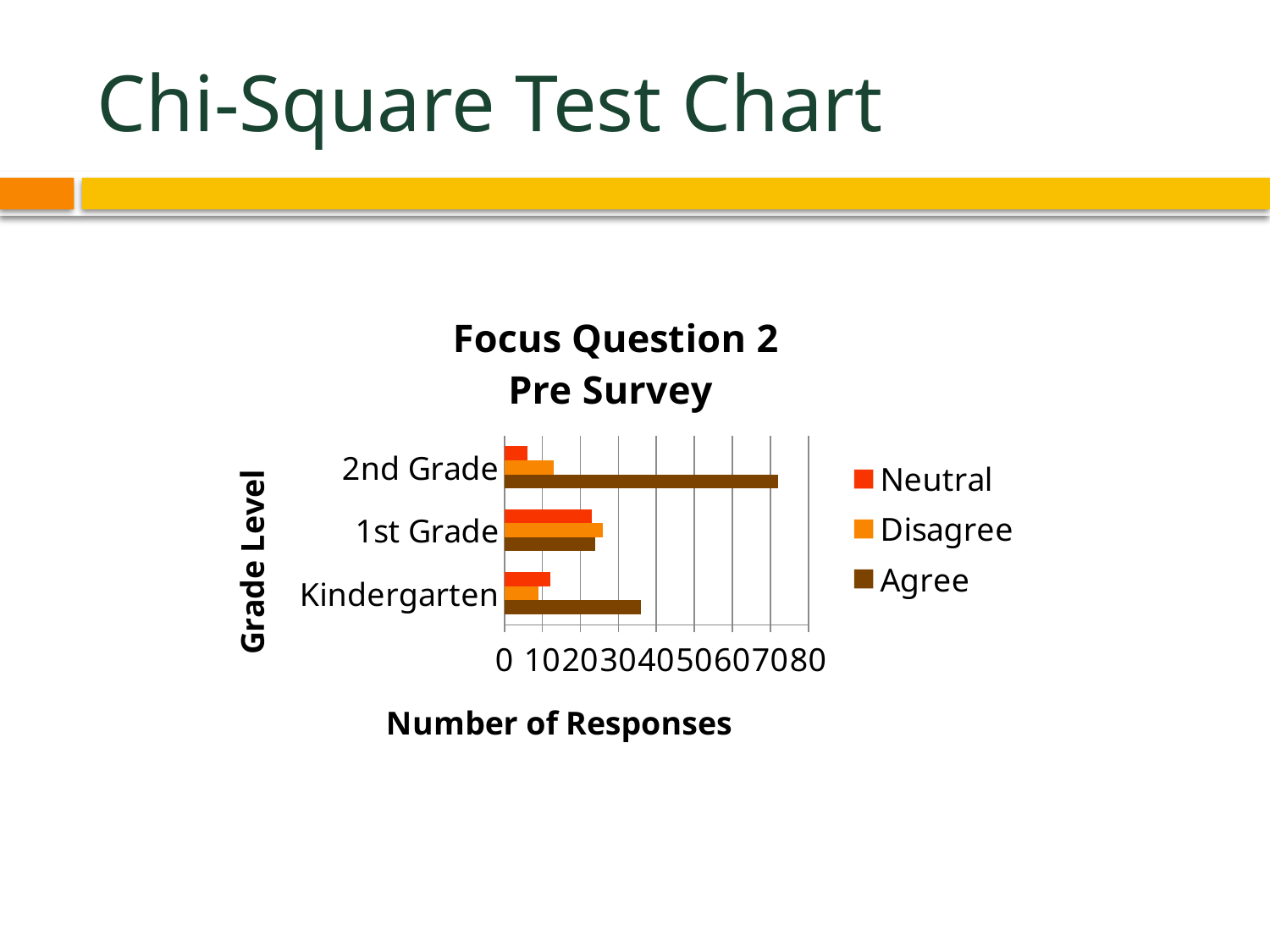
What kind of chart is shown on the slide? bar chart Is the Agree value for Kindergarten greater or less than 30? greater How many grade levels are shown on the chart? 3 How many series does the chart legend list? 3 Is the Neutral value for 2nd Grade greater or less than 10? less Is the Agree value for 2nd Grade greater or less than 60? greater What is the label of the horizontal axis of the chart? Number of Responses Which grade level has the highest Agree value? 2nd Grade Which grade level has the highest Neutral value? 1st Grade Which grade level has the lowest Neutral value? 2nd Grade Which grade level has the lowest Agree value? 1st Grade Which is larger, the Agree value for 2nd Grade or the Agree value for Kindergarten? 2nd Grade